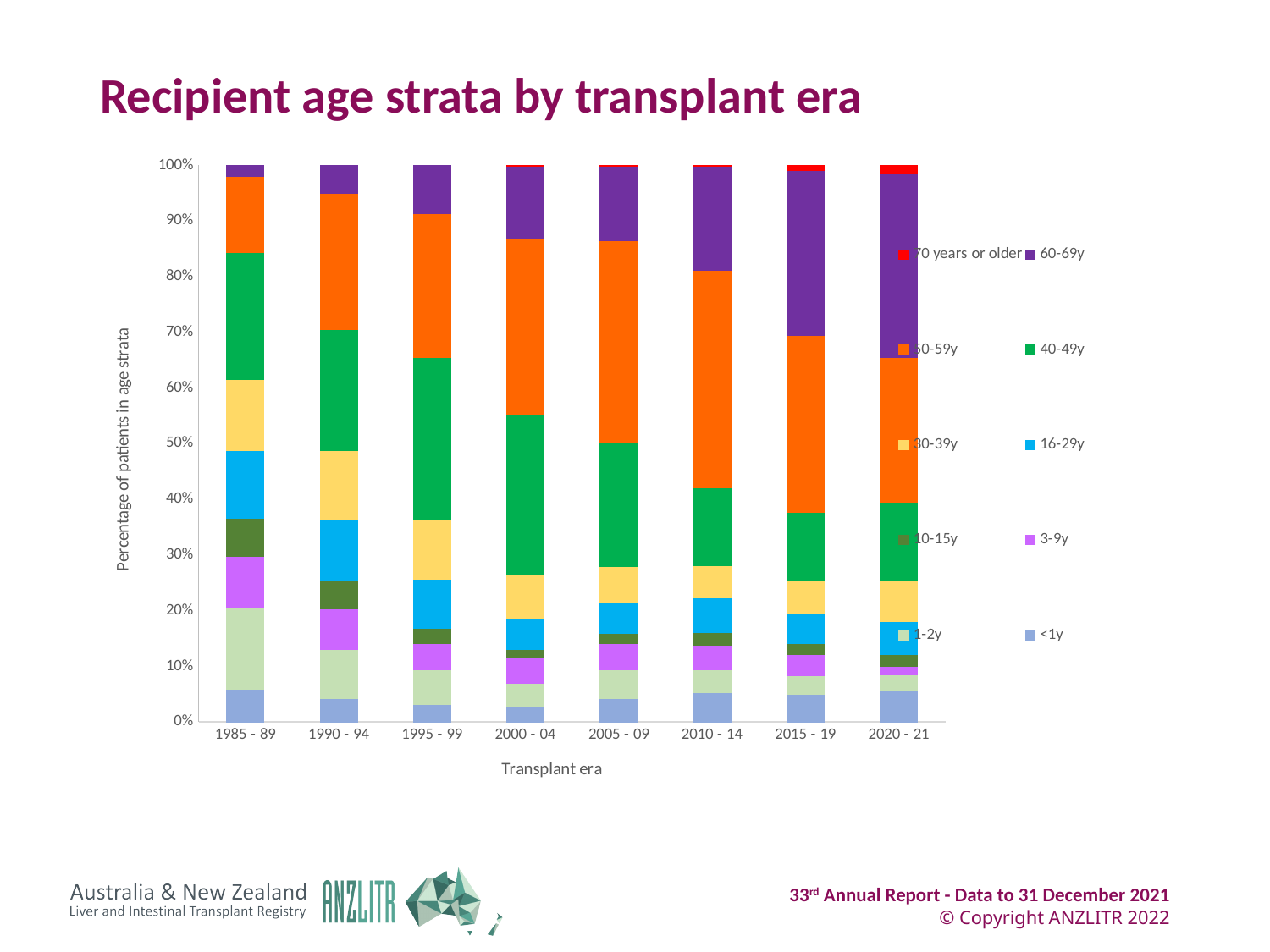
Which transplant era has the largest 40-49y segment? 1995 - 99 How many transplant eras are shown along the x axis? 8 How many age strata series does the legend list? 10 Is the 16-29y segment larger in 1985 - 89 or in 2020 - 21? 1985 - 89 Does the share of the 60-69y age stratum rise or fall across the transplant eras from 1985 - 89 to 2020 - 21? Rise Does the share of the 40-49y age stratum rise or fall across the transplant eras from 1985 - 89 to 2020 - 21? Fall What is the label of the vertical axis? Percentage of patients in age strata Which transplant era has the largest 60-69y segment? 2020 - 21 Is the 60-69y segment larger in 2020 - 21 or in 1985 - 89? 2020 - 21 Is the share of the <1y stratum in 1985 - 89 greater or less than 10%? less What kind of chart is shown on the slide? Stacked bar chart What is the title of the chart? Recipient age strata by transplant era